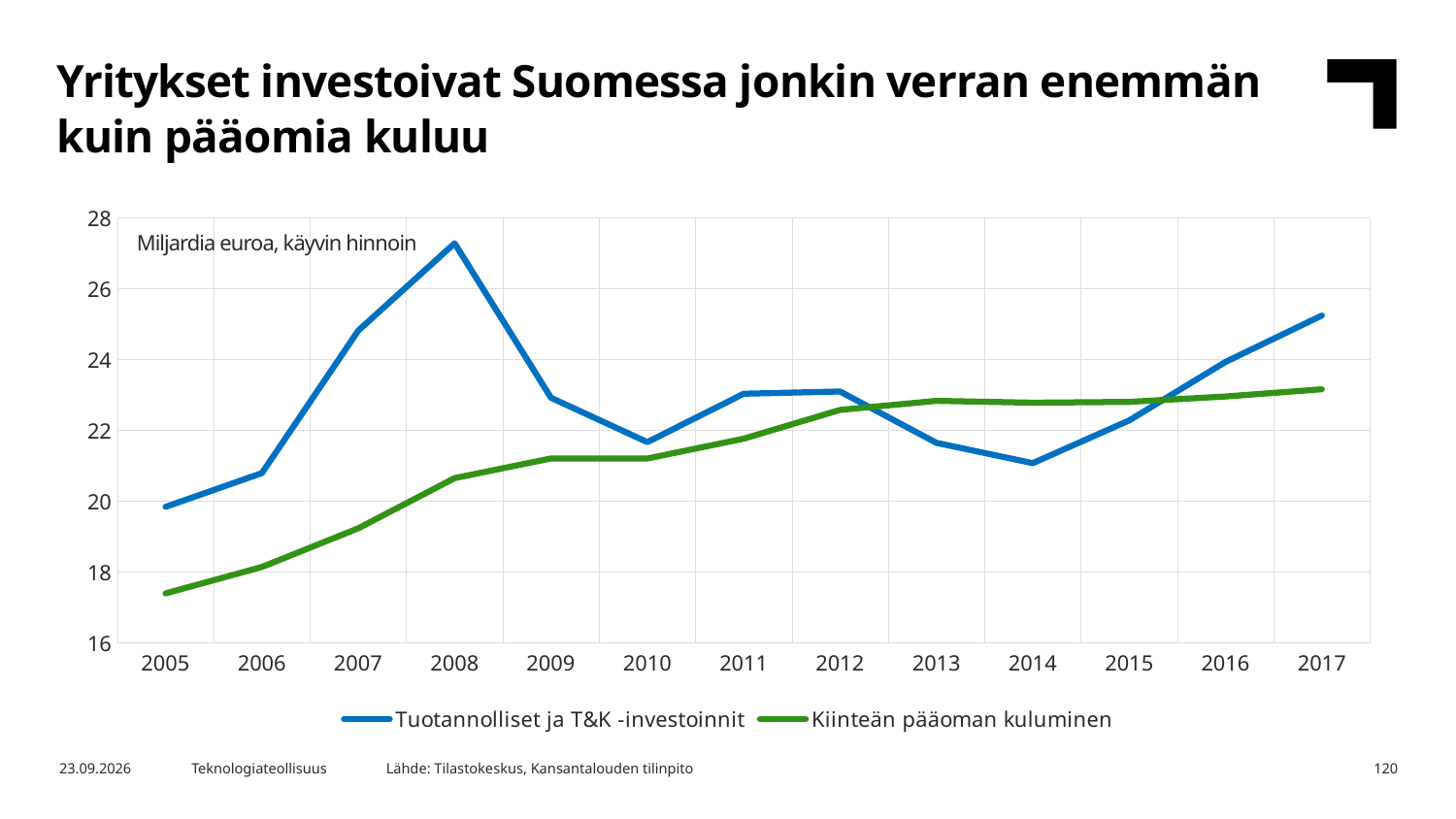
Does the series 'Kiinteän pääoman kuluminen' generally rise or fall from 2005 to 2017? Rise In 2014, which series has the higher value: 'Tuotannolliset ja T&K -investoinnit' or 'Kiinteän pääoman kuluminen'? Kiinteän pääoman kuluminen In which year does the series 'Tuotannolliset ja T&K -investoinnit' reach its highest value? 2008 What unit is stated in the text inside the chart area? Miljardia euroa, käyvin hinnoin In which year is the series 'Tuotannolliset ja T&K -investoinnit' at its lowest? 2005 In which year is the series 'Kiinteän pääoman kuluminen' at its lowest? 2005 Is the value for 'Tuotannolliset ja T&K -investoinnit' in 2008 greater or less than 26? greater What type of chart is shown on the slide? Line chart How many years are shown on the x axis? 13 How many series does the legend list? 2 Is the value for 'Tuotannolliset ja T&K -investoinnit' in 2017 greater or less than 24? greater Is the value for 'Kiinteän pääoman kuluminen' in 2005 greater or less than 18? less